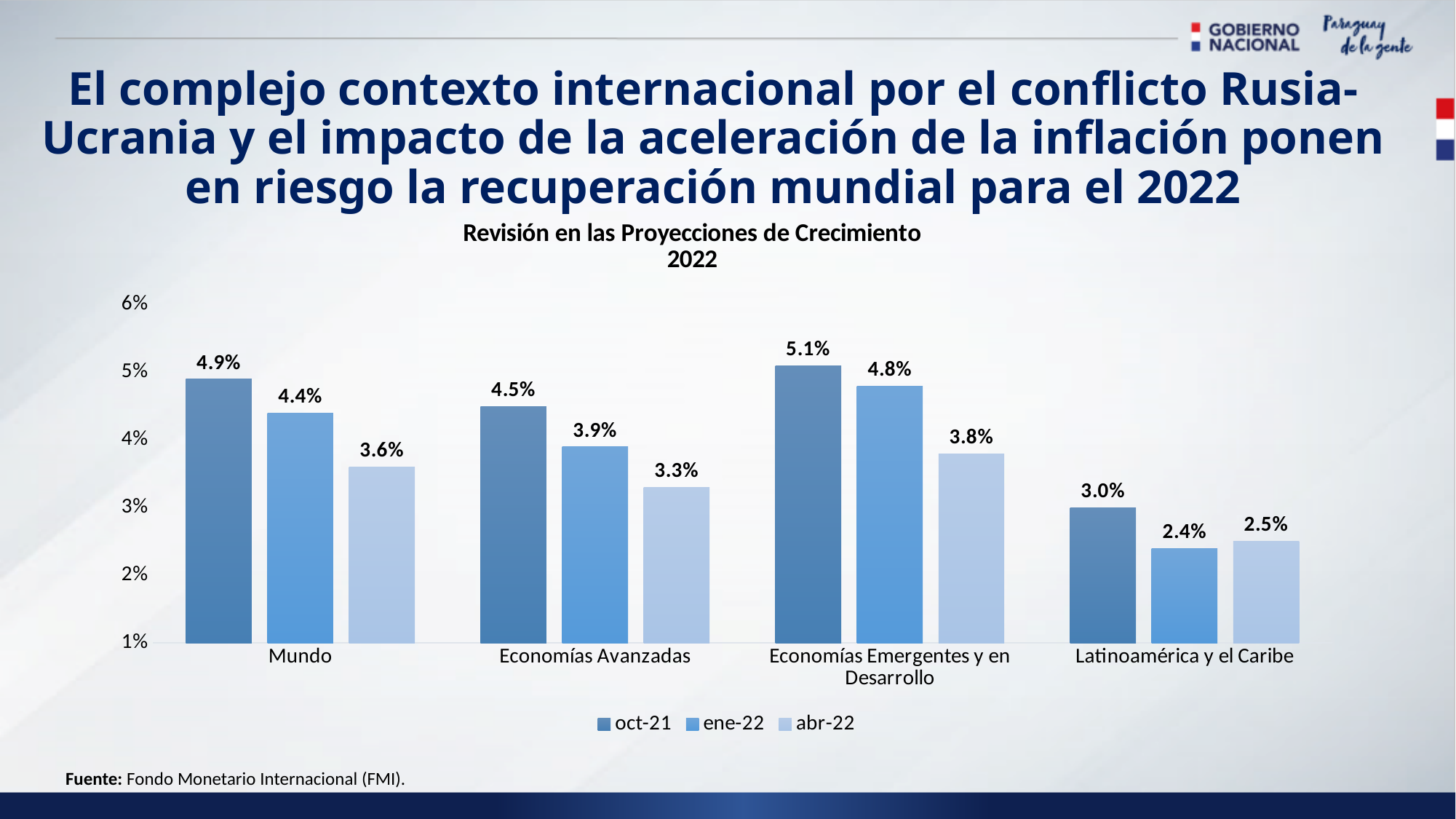
What kind of chart is shown on the slide? Bar chart How many categories are shown on the x axis? 4 Which category has the highest oct-21 projection? Economías Emergentes y en Desarrollo What is the abr-22 growth projection for Mundo? 3.6% For Mundo, do the projections rise or fall from oct-21 to abr-22? Fall What is the difference between the oct-21 and abr-22 projections for Economías Avanzadas? 1.2% For Latinoamérica y el Caribe, which is larger: the ene-22 or the abr-22 projection? abr-22 What is the title of the chart? Revisión en las Proyecciones de Crecimiento 2022 Which category has the lowest abr-22 projection? Latinoamérica y el Caribe What is the ene-22 growth projection for Latinoamérica y el Caribe? 2.4% How many series does the legend list? 3 What is the oct-21 growth projection for Economías Emergentes y en Desarrollo? 5.1%